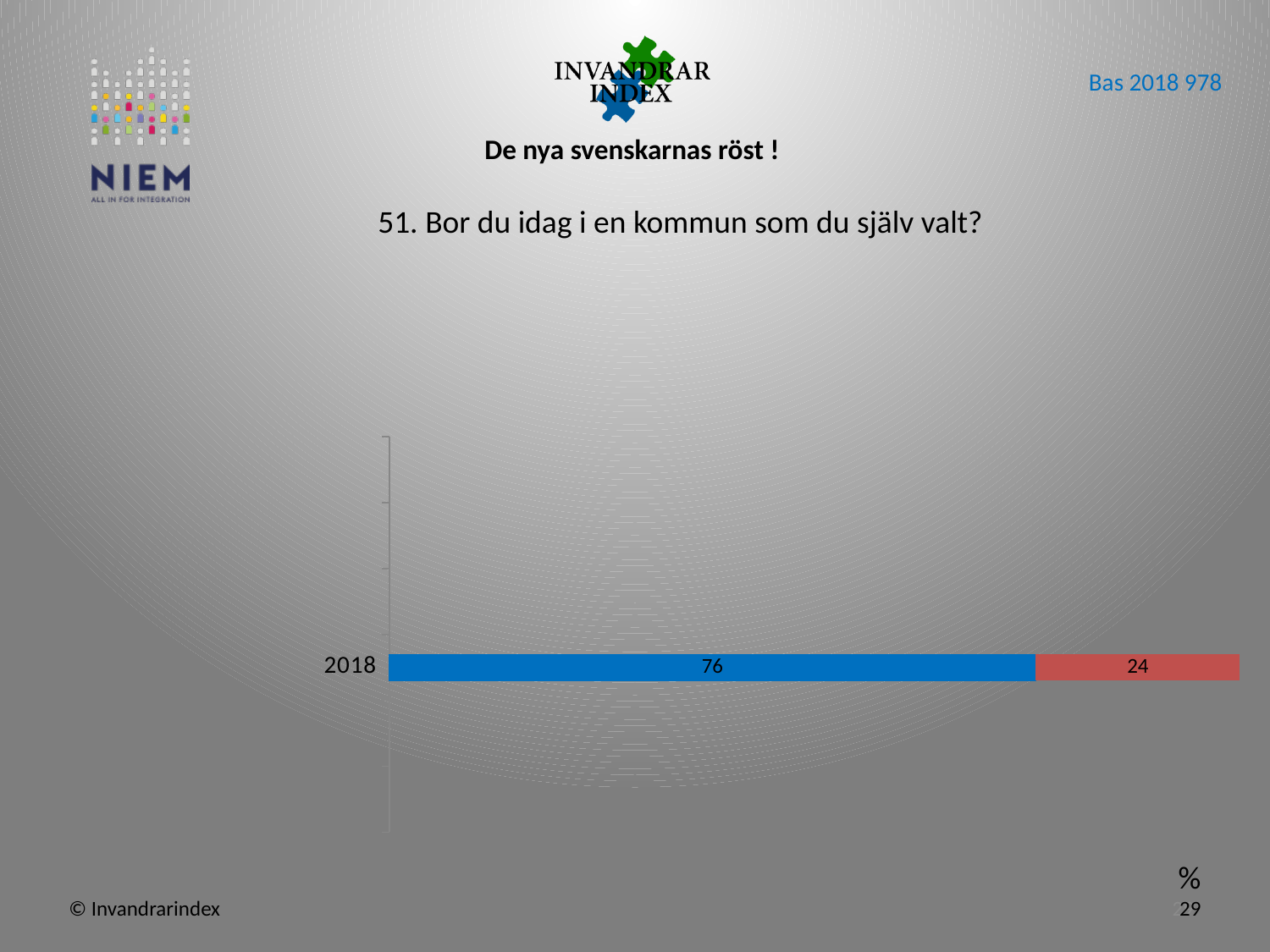
How many bars (categories) does the chart show? 1 What question does the chart on the slide relate to? 51. Bor du idag i en kommun som du själv valt? What is the total of the two segments in the 2018 bar? 100 Is the value of the red segment of the 2018 bar greater or less than 50? less What value is shown on the blue segment of the 2018 bar? 76 What is the difference between the blue segment value and the red segment value in the 2018 bar? 52 Is the value of the blue segment of the 2018 bar greater or less than 50? greater What is the category label shown next to the bar? 2018 What kind of chart is shown on the slide? bar chart What value is shown on the red segment of the 2018 bar? 24 Which segment of the 2018 bar is larger, the blue one or the red one? the blue one